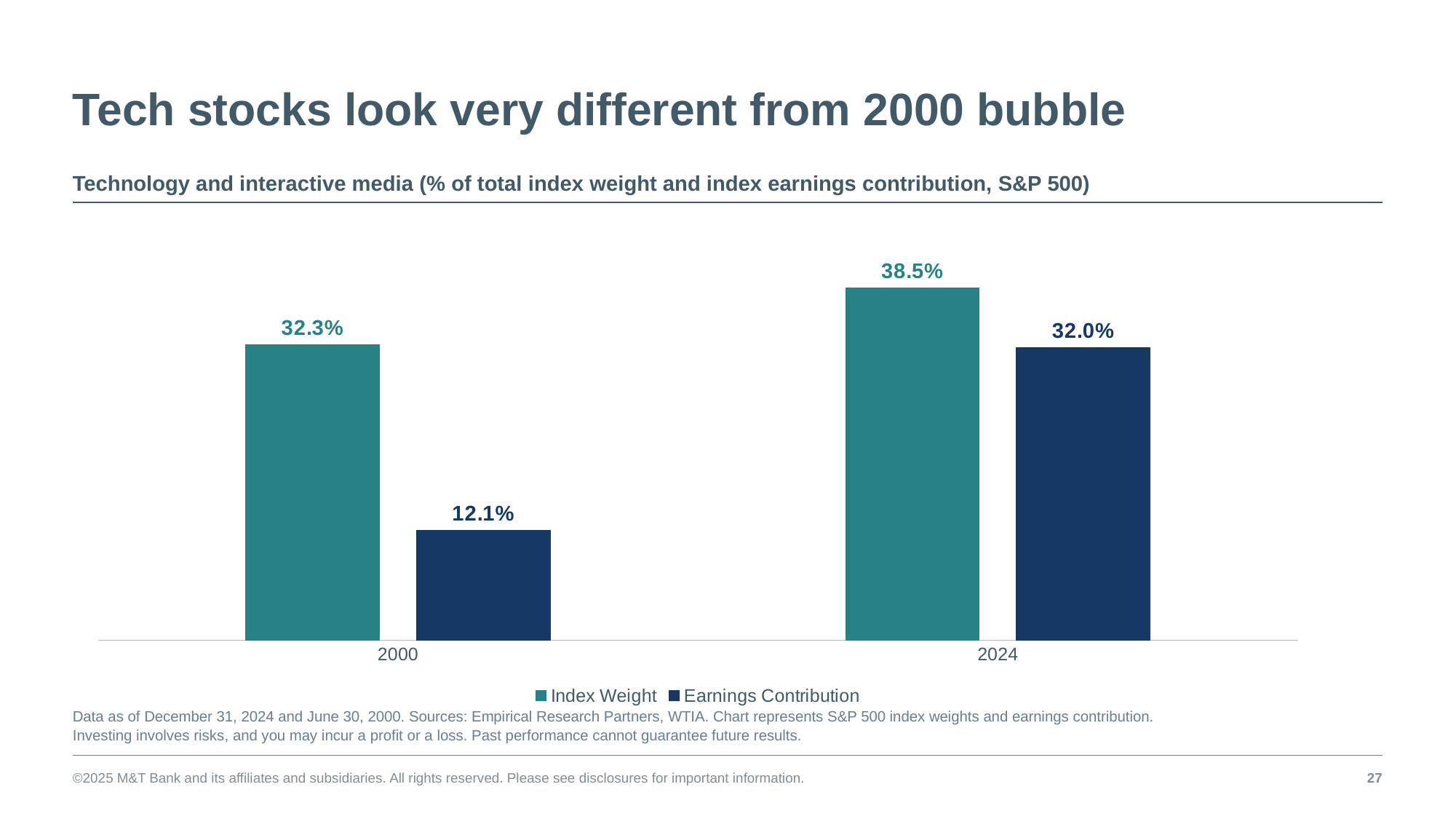
What is the Earnings Contribution value for 2000? 12.1% What is the Index Weight value for 2024? 38.5% Which series is shown in dark navy blue? Earnings Contribution What is the Index Weight value for 2000? 32.3% What is the difference between Index Weight and Earnings Contribution in 2024? 6.5% Which bar on the chart has the lowest value? Earnings Contribution in 2000 What kind of chart is shown on the slide? Bar chart What is the difference between Index Weight and Earnings Contribution in 2000? 20.2% How many series does the legend list? 2 Is the Earnings Contribution larger in 2000 or in 2024? 2024 Which year has the higher Index Weight? 2024 What is the Earnings Contribution value for 2024? 32.0%